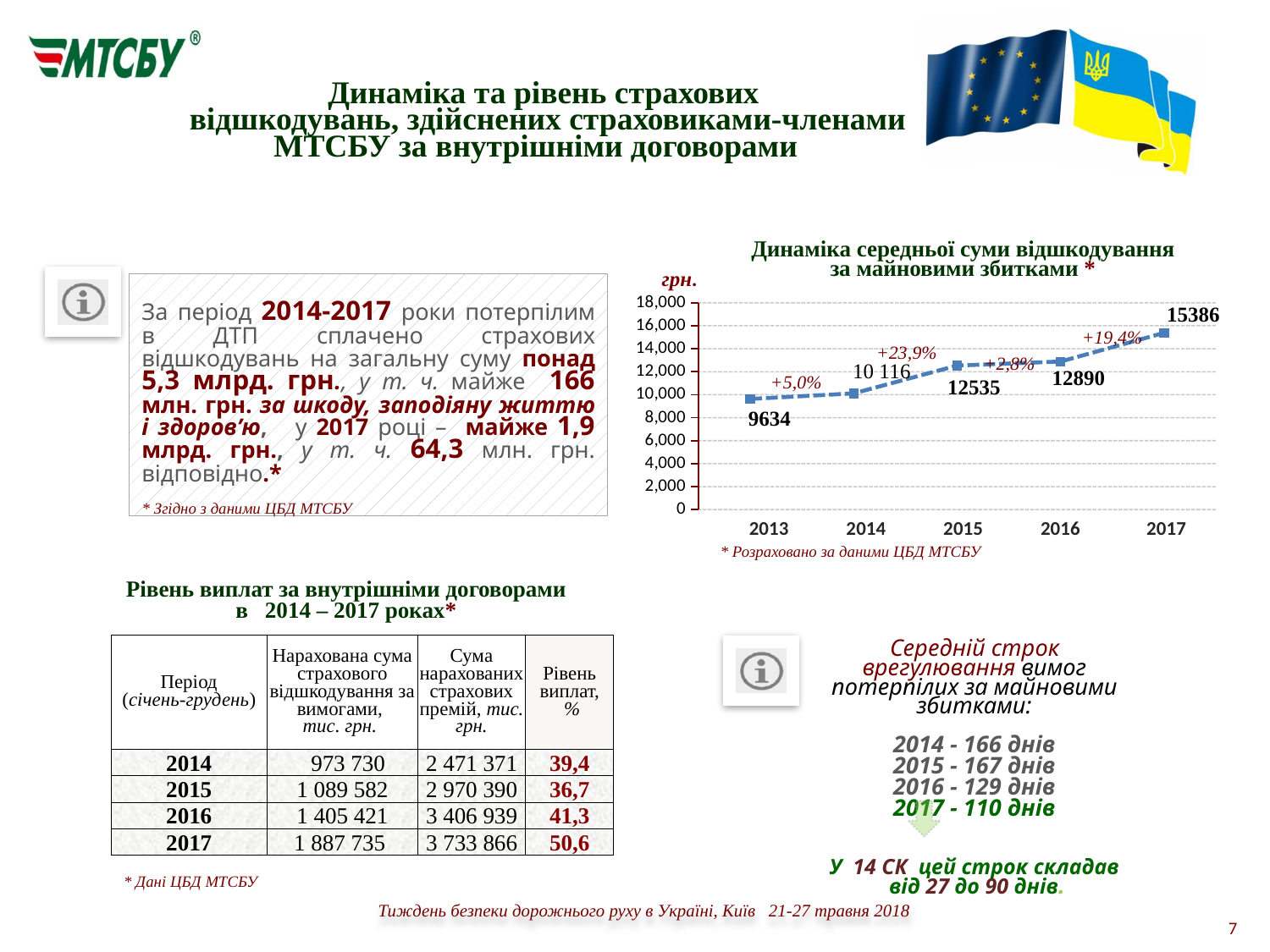
Which year has the lowest average compensation amount on the chart? 2013 What is the difference between the values for 2017 and 2016 on the chart? 2496 What value is shown for 2015 on the chart? 12535 What is the average compensation amount for 2017 on the chart? 15386 How many years are plotted on the chart? 5 Which year has the highest average compensation amount on the chart? 2017 What is the average compensation amount for 2013 on the chart? 9634 What kind of chart is shown on the slide? line chart Is the value for 2016 on the chart greater or less than 14,000? less What value is shown for 2014 on the chart? 10 116 Which is larger on the chart, the value for 2015 or the value for 2014? 2015 Do the values on the chart rise or fall from 2013 to 2017? rise